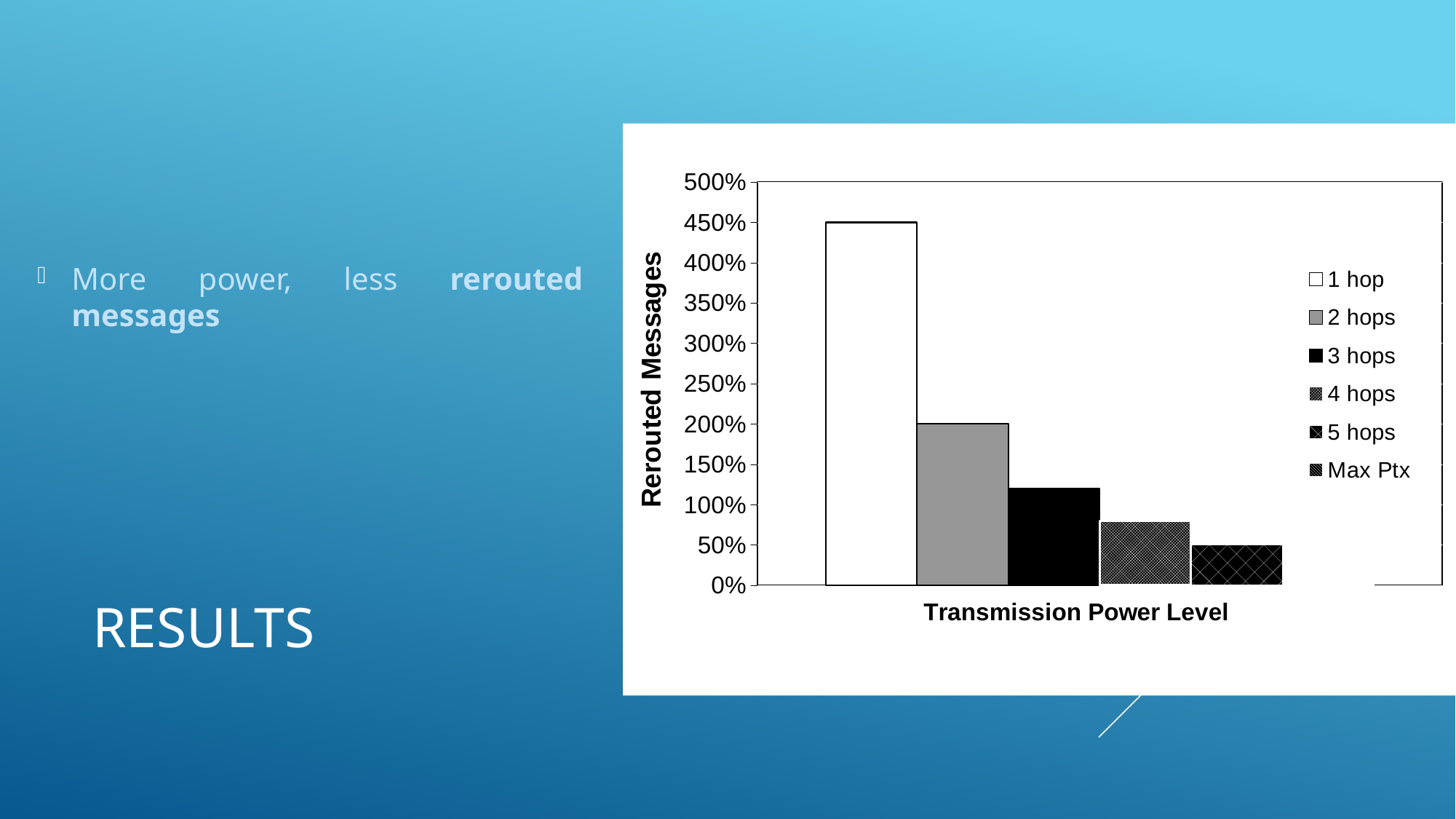
What is the value of the 1 hop bar? 450% Is the value for 3 hops greater or less than 100%? greater What is the difference between the 1 hop bar and the 2 hops bar? 250% Which is larger, the 3 hops bar or the 4 hops bar? 3 hops Do the bars rise or fall from left to right across the chart? fall Is the value for 4 hops greater or less than 100%? less What is the title of the vertical axis? Rerouted Messages Which series has the tallest bar? 1 hop What is the value of the 2 hops bar? 200% How many series does the legend list? 6 What kind of chart is shown on the slide? bar chart What is the value of the 5 hops bar? 50%